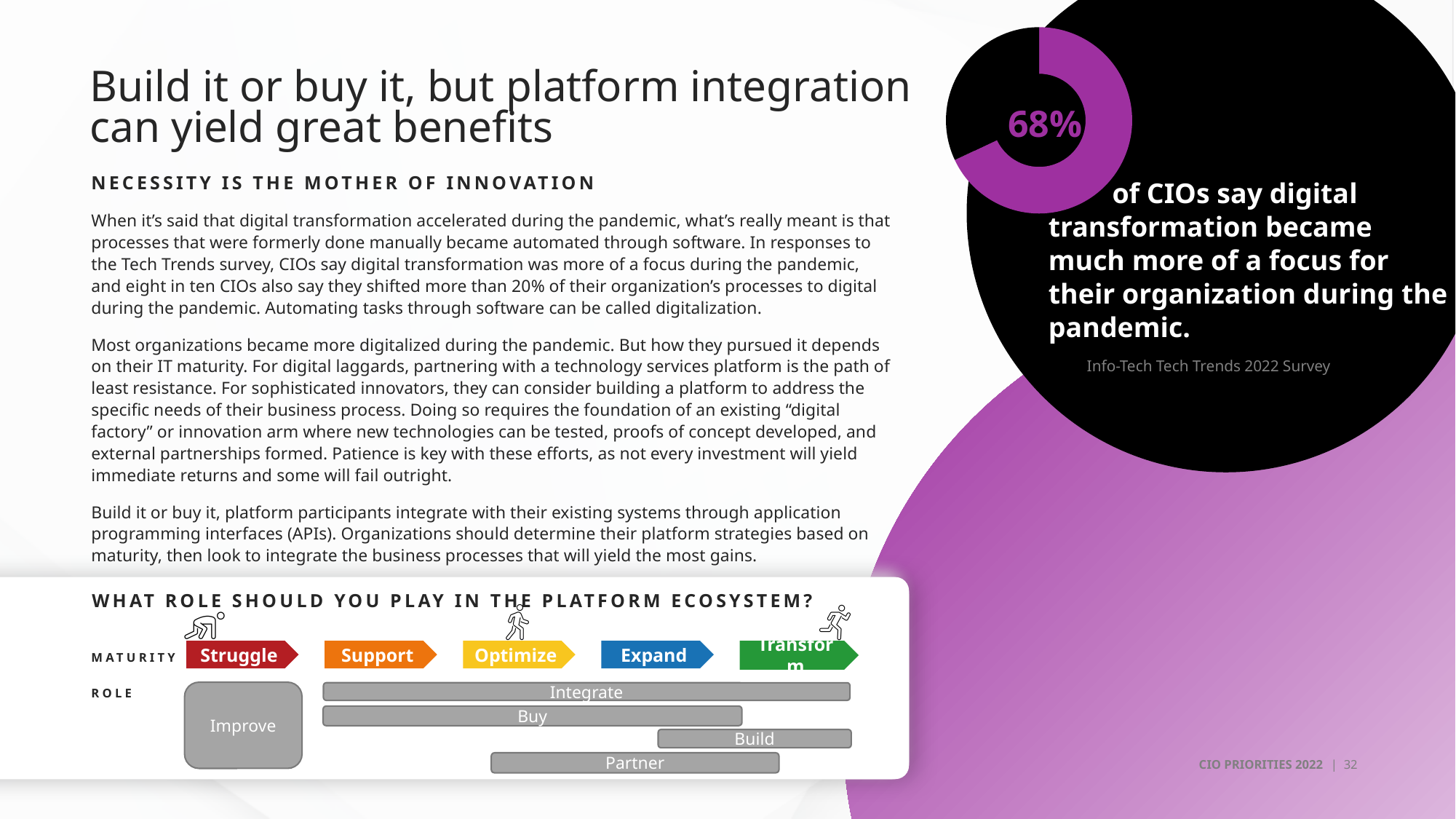
What share of the donut chart does the highlighted purple segment represent? 68% What percentage is shown in the centre of the donut chart? 68% Is the value shown in the donut chart greater or less than 50%? greater What does the 68% in the donut chart represent? CIOs who say digital transformation became much more of a focus for their organization during the pandemic What kind of chart is shown in the black circle at the top right of the slide? Donut chart What is the source cited for the donut chart? Info-Tech Tech Trends 2022 Survey How many segments does the donut chart have? 2 Which is larger in the donut chart: the highlighted purple segment or the remaining segment? The highlighted purple segment